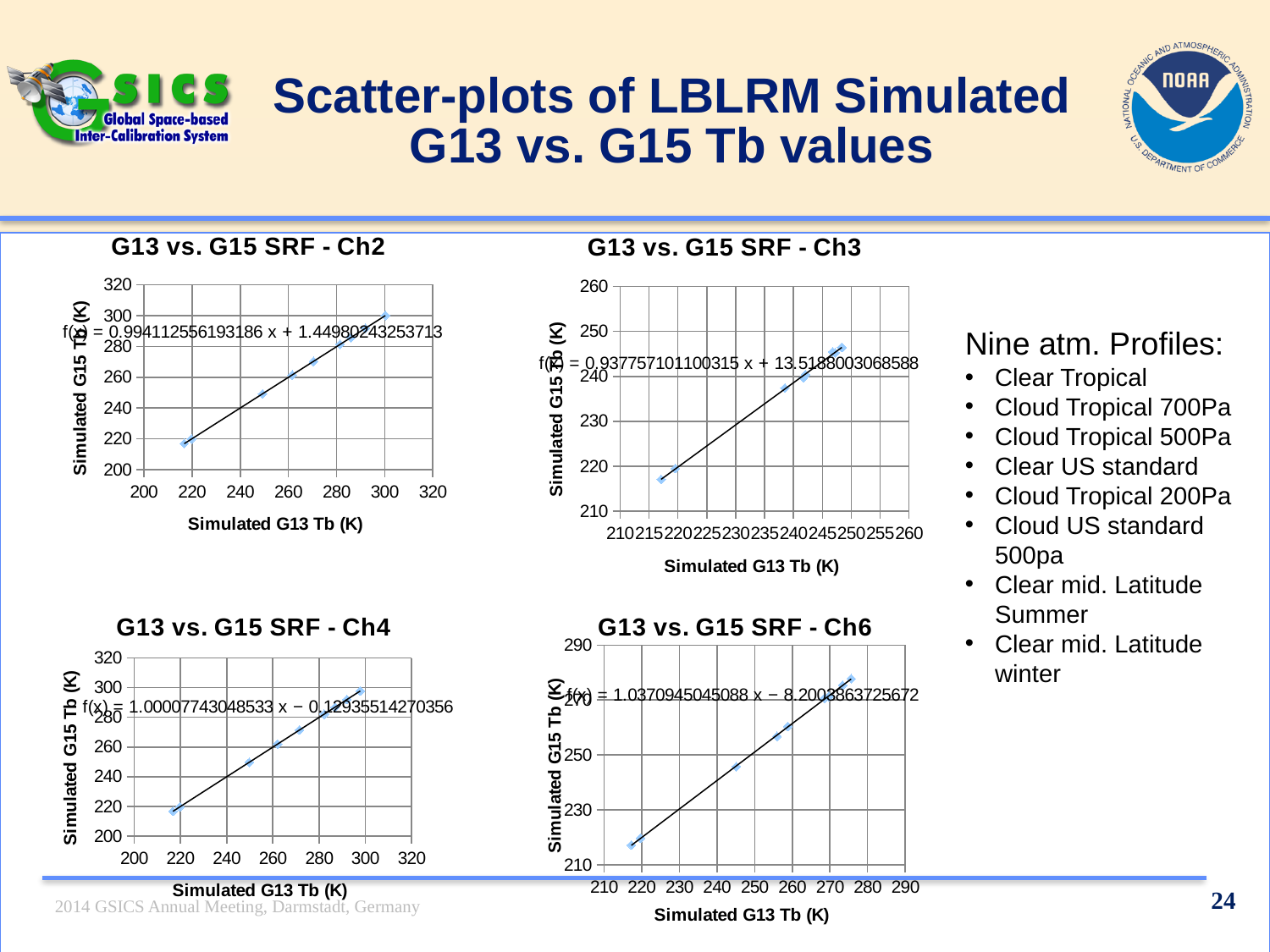
What is the slope of the fitted line shown in the "G13 vs. G15 SRF - Ch2" chart? 0.994112556193186 What kind of chart is the "G13 vs. G15 SRF - Ch2" chart? Scatter plot In the "G13 vs. G15 SRF - Ch2" chart, is the lowest plotted Simulated G15 Tb value greater or less than 240? less In the "G13 vs. G15 SRF - Ch6" chart, is the lowest plotted Simulated G15 Tb value greater or less than 230? less In the "G13 vs. G15 SRF - Ch3" chart, do the Simulated G15 Tb values rise or fall as Simulated G13 Tb increases? Rise What is the title of the chart in the bottom-right position of the slide? G13 vs. G15 SRF - Ch6 What is the intercept of the fitted line shown in the "G13 vs. G15 SRF - Ch3" chart? 13.5188003068588 In the "G13 vs. G15 SRF - Ch4" chart, is the highest plotted Simulated G15 Tb value greater or less than 280? greater How many charts are shown on the slide? 4 What is the x-axis title of the "G13 vs. G15 SRF - Ch4" chart? Simulated G13 Tb (K)